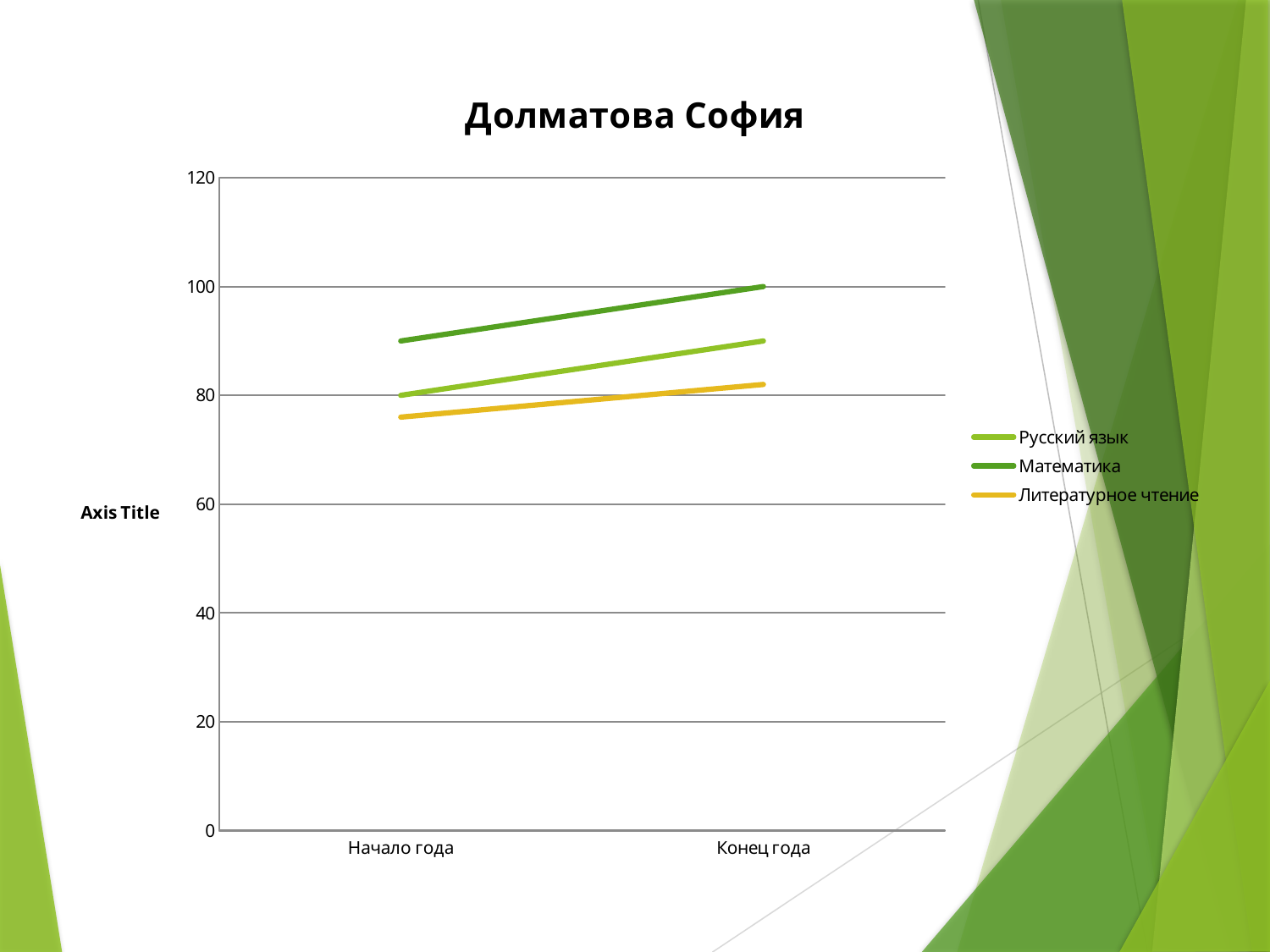
What is the value for Математика at Конец года? 100 Is the value for Математика at Начало года greater or less than 80? greater Which series has the lowest value at Начало года? Литературное чтение What kind of chart is shown on the slide? line chart What is the value for Русский язык at Начало года? 80 How many categories are shown on the x axis? 2 Which series has the highest value at Конец года? Математика Is the value for Русский язык at Конец года greater or less than 80? greater Does the value for Русский язык rise or fall from Начало года to Конец года? rise Is the value for Литературное чтение at Начало года greater or less than 80? less What is the title of the chart? Долматова София How many series does the legend list? 3